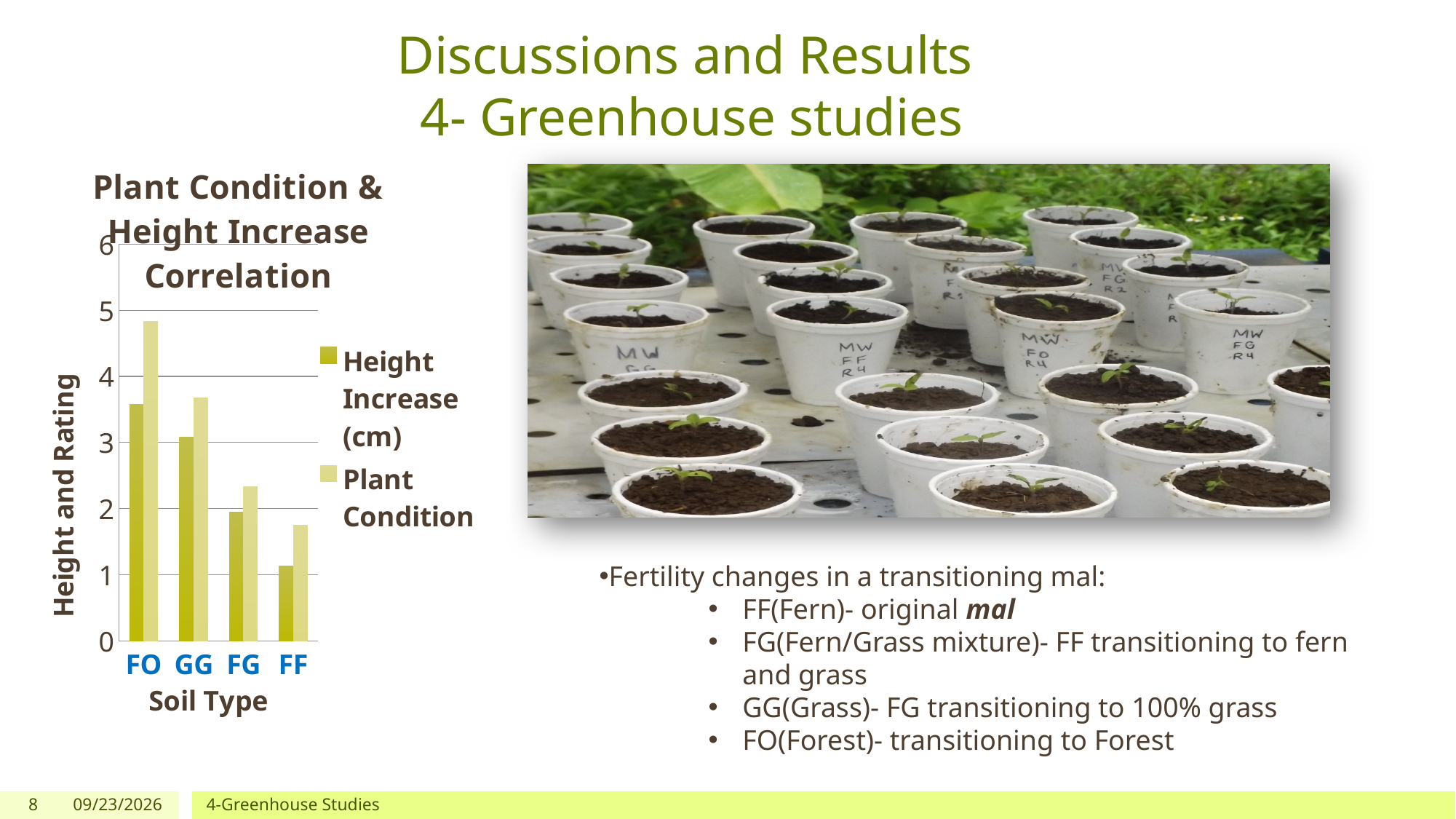
Is the Plant Condition value for FO greater or less than 4? greater Which soil type has the lowest Plant Condition value? FF Which soil type has the highest Plant Condition value? FO What kind of chart is shown on the slide? bar chart How many series does the legend of the chart list? 2 Do the Height Increase (cm) values rise or fall moving from FO to FF along the x axis? fall Which soil type has the lowest Height Increase (cm) value? FF What is the title of the chart? Plant Condition & Height Increase Correlation Is the Height Increase (cm) value for FF greater or less than 2? less Which is larger for FG: the Height Increase (cm) value or the Plant Condition value? Plant Condition How many soil types are shown on the x axis of the chart? 4